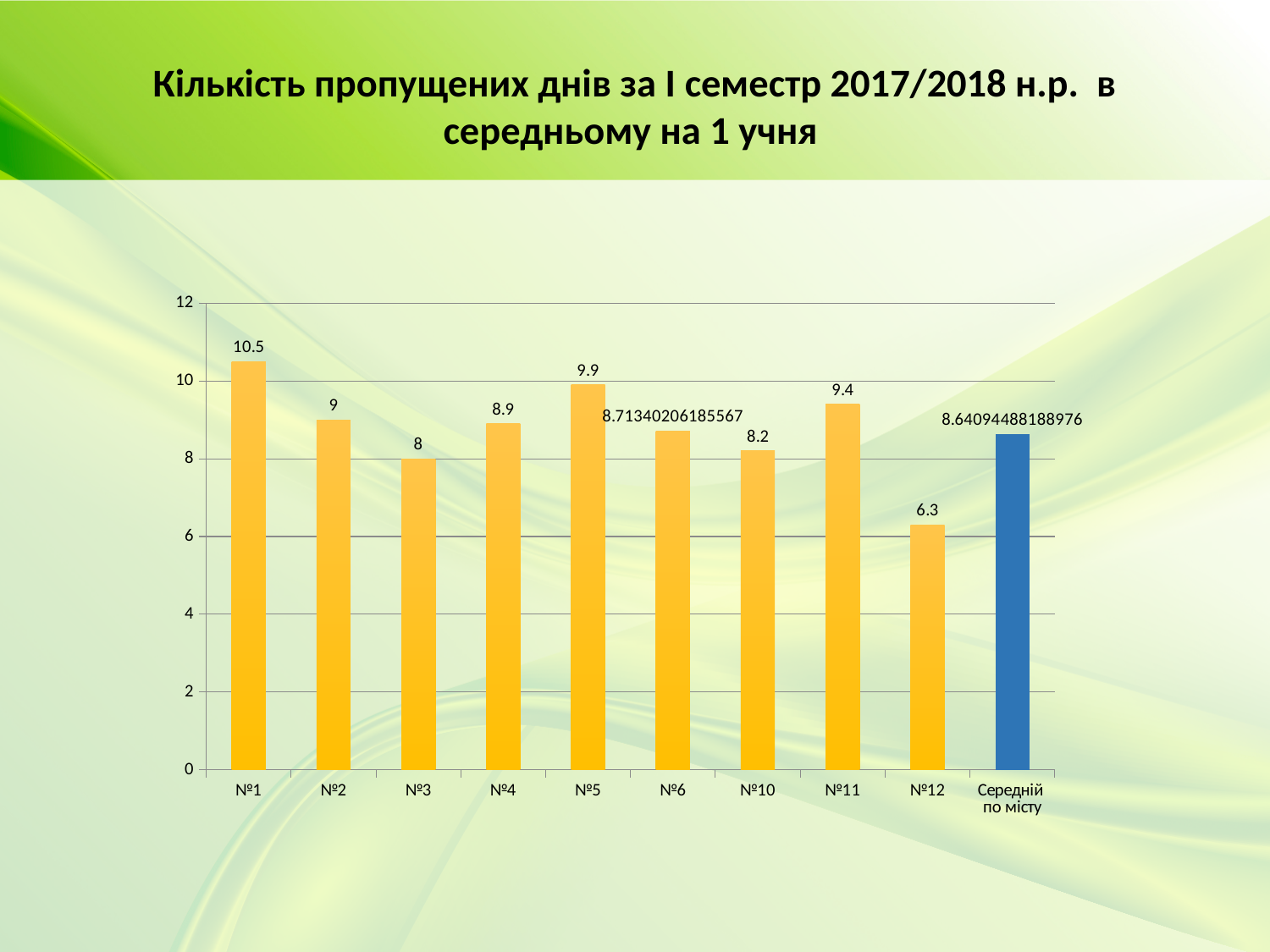
How many categories are shown on the x axis? 10 Is the value for №3 greater or less than 10? less Which is larger, the value for №5 or the value for №11? №5 What is the value for №12? 6.3 Which bar is coloured blue rather than yellow? Середній по місту What is the value for Середній по місту? 8.64094488188976 What is the difference between the values for №1 and №12? 4.2 What is the value for №6? 8.71340206185567 Which category has the lowest value? №12 Which category has the highest value? №1 What kind of chart is shown on the slide? bar chart What is the value for №1? 10.5